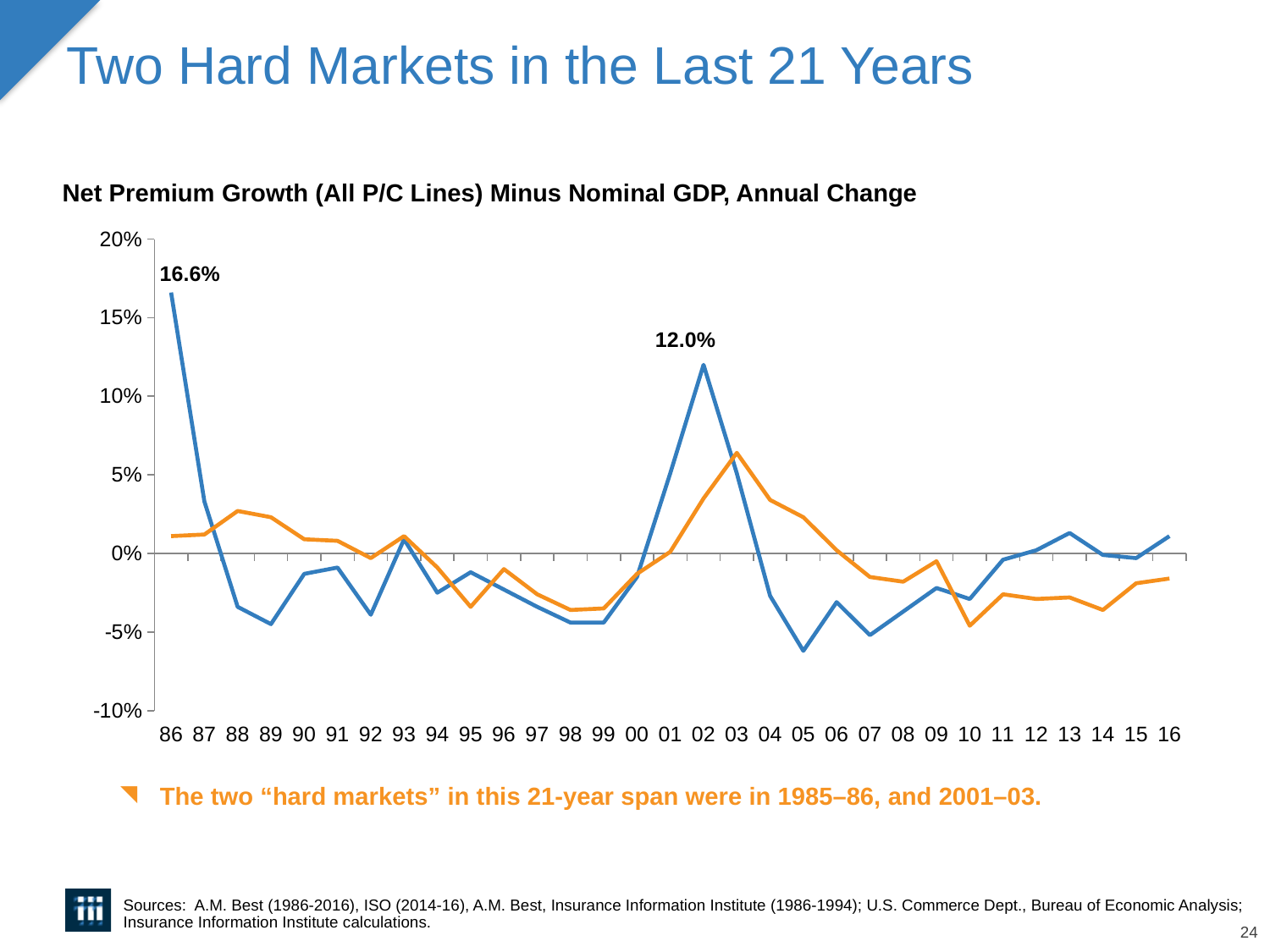
In 02, which line has the higher value, the blue line or the orange line? blue line In which year does the blue line reach its highest value? 86 How many years are shown on the x axis? 31 What kind of chart is shown on the slide? line chart What is the difference between the two labeled values, 16.6% and 12.0%? 4.6 percentage points Does the blue line rise or fall from 86 to 88? fall What is the title of the chart? Net Premium Growth (All P/C Lines) Minus Nominal GDP, Annual Change How many lines are plotted on the chart? 2 What value is labeled on the blue line for 86? 16.6% Is the value of the blue line for 05 greater or less than -5%? less What value is labeled on the blue line for 02? 12.0% Is the value of the orange line for 03 greater or less than 5%? greater